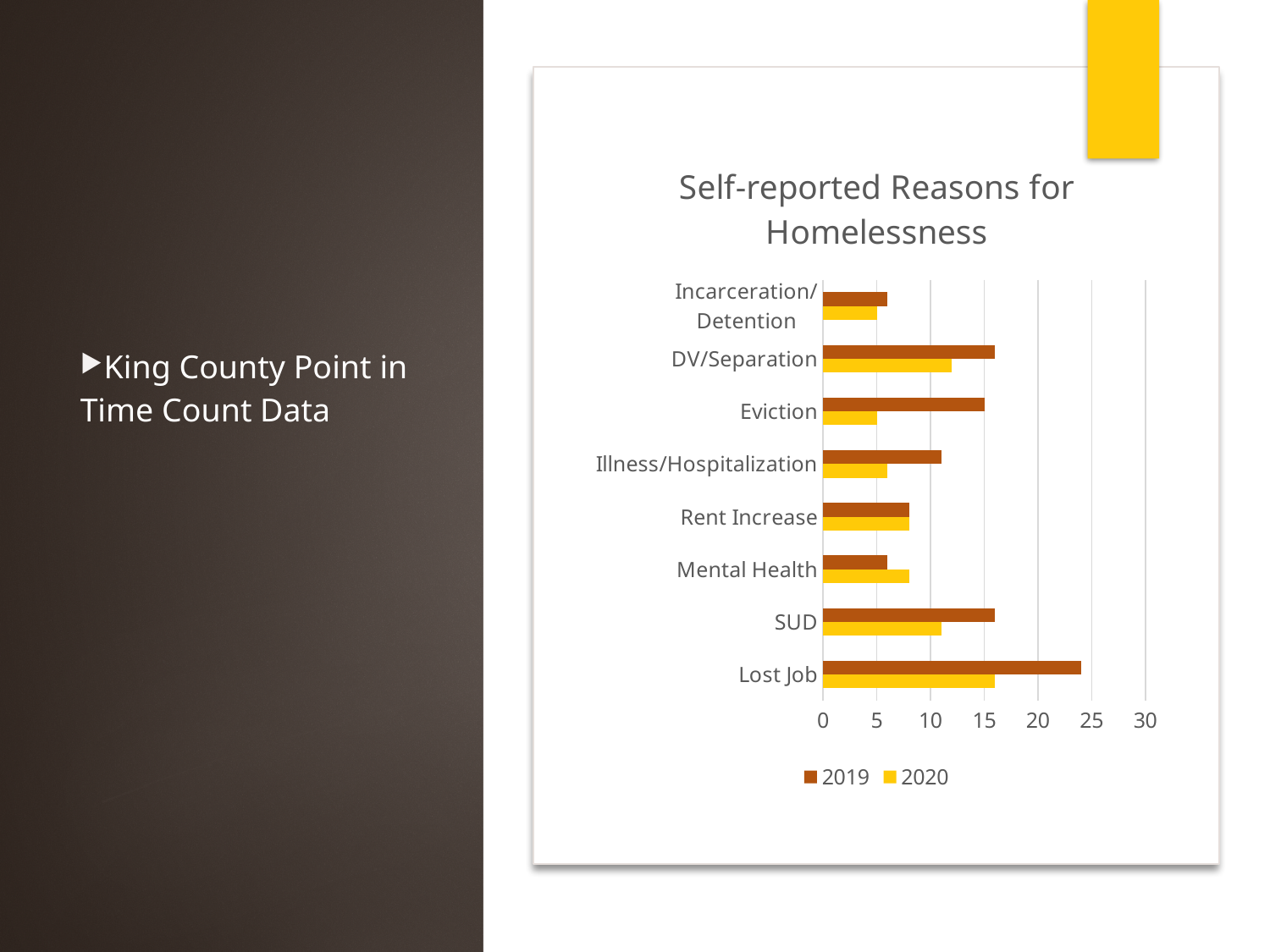
How many reason categories are shown on the chart? 8 Which category has the highest value for 2019? Lost Job Which category has the highest value for 2020? Lost Job How many series does the legend list? 2 For Eviction, which year has the larger value, 2019 or 2020? 2019 Is the 2019 value for SUD greater or less than 10? greater What kind of chart is shown on the slide? bar chart Is the 2019 value for Lost Job greater or less than 20? greater Is the 2020 value for Illness/Hospitalization greater or less than 10? less For Mental Health, which year has the larger value, 2019 or 2020? 2020 What is the title of the chart? Self-reported Reasons for Homelessness